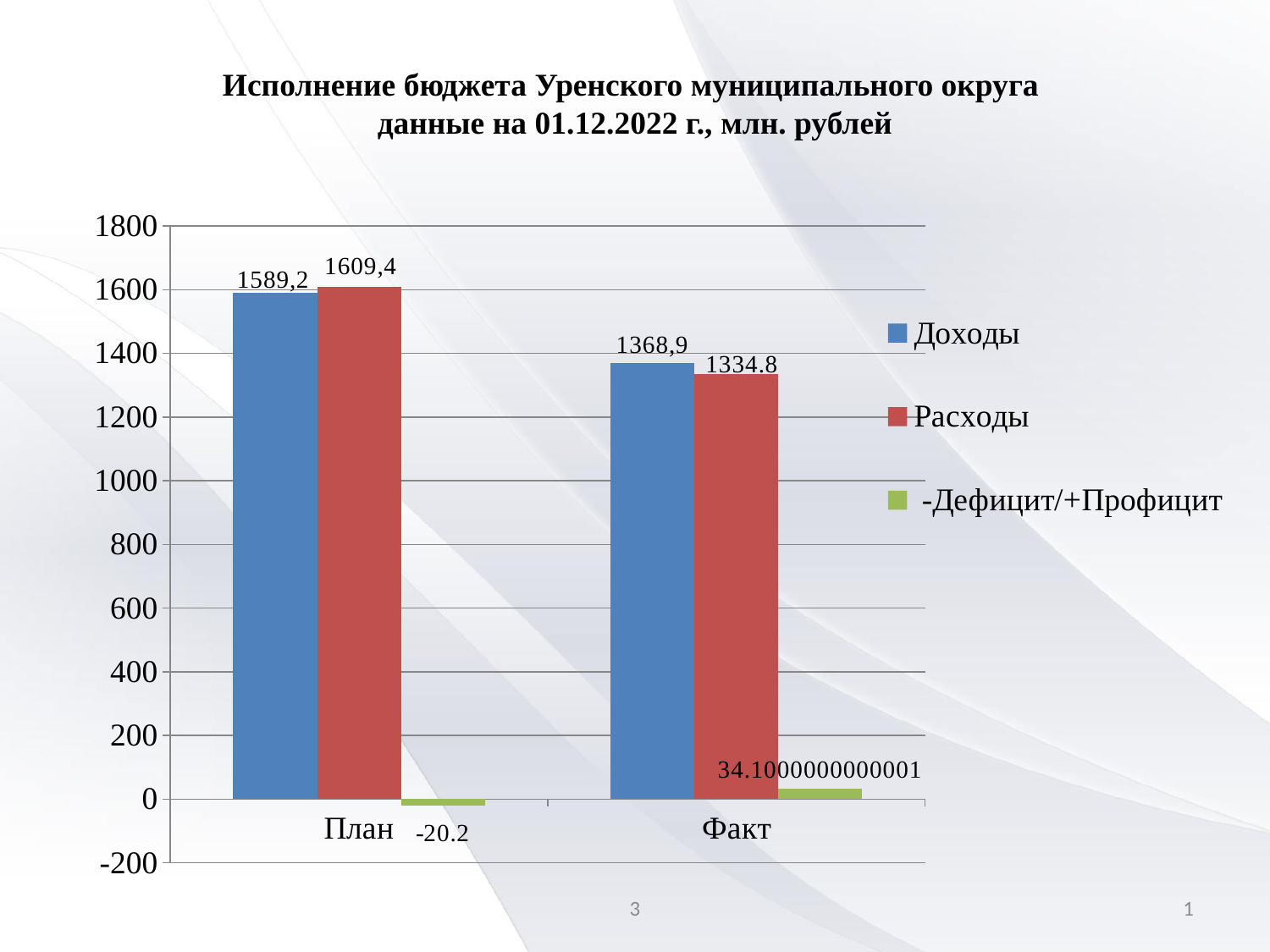
Which series is shown in green in the legend? -Дефицит/+Профицит Which category has the higher value for Расходы, План or Факт? План What is the difference between Доходы for План and Доходы for Факт? 220,3 What kind of chart is shown on the slide? Bar chart What is the value of -Дефицит/+Профицит for Факт? 34.1000000000001 How many categories are shown on the x axis? 2 What is the value of Доходы for План? 1589,2 What is the value of Расходы for Факт? 1334.8 What is the value of -Дефицит/+Профицит for План? -20.2 For Факт, which is larger, Доходы or Расходы? Доходы What is the difference between Расходы and Доходы for План? 20,2 How many series does the legend list? 3